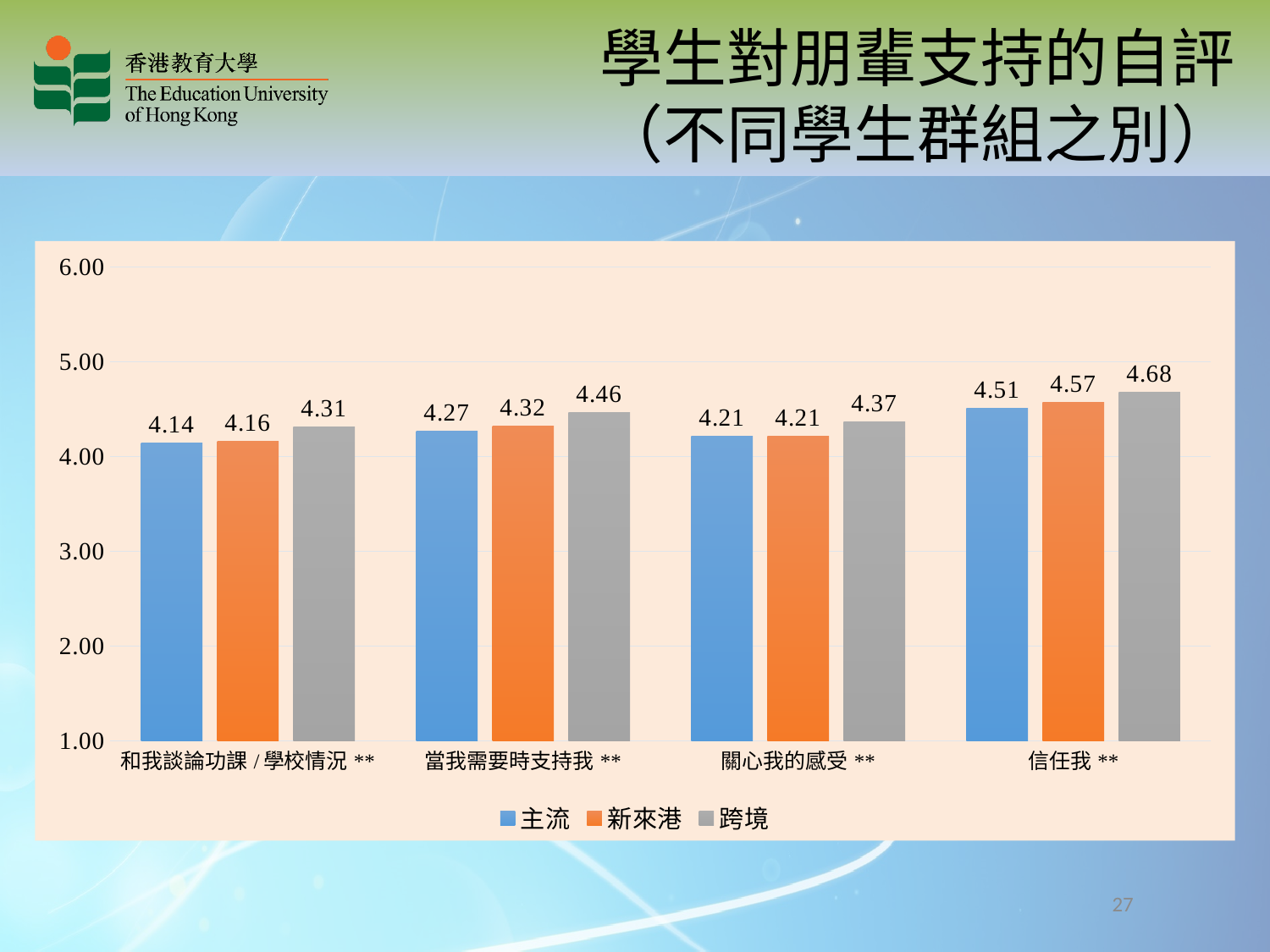
What is the difference between the 跨境 and 主流 values in the 信任我 ** category? 0.17 Which colour represents the 新來港 series in the legend? orange How many categories are shown on the x axis? 4 In the 關心我的感受 ** category, which is larger: the 跨境 value or the 主流 value? 跨境 Which category has the highest value for 跨境? 信任我 ** Is the value for 主流 in the 信任我 ** category greater or less than 4.00? greater What is the value for 新來港 in the 當我需要時支持我 ** category? 4.32 What is the value for 主流 in the 和我談論功課 / 學校情況 ** category? 4.14 What kind of chart is shown on the slide? bar chart Which category has the lowest value for 主流? 和我談論功課 / 學校情況 ** How many series does the legend list? 3 What is the value for 跨境 in the 信任我 ** category? 4.68